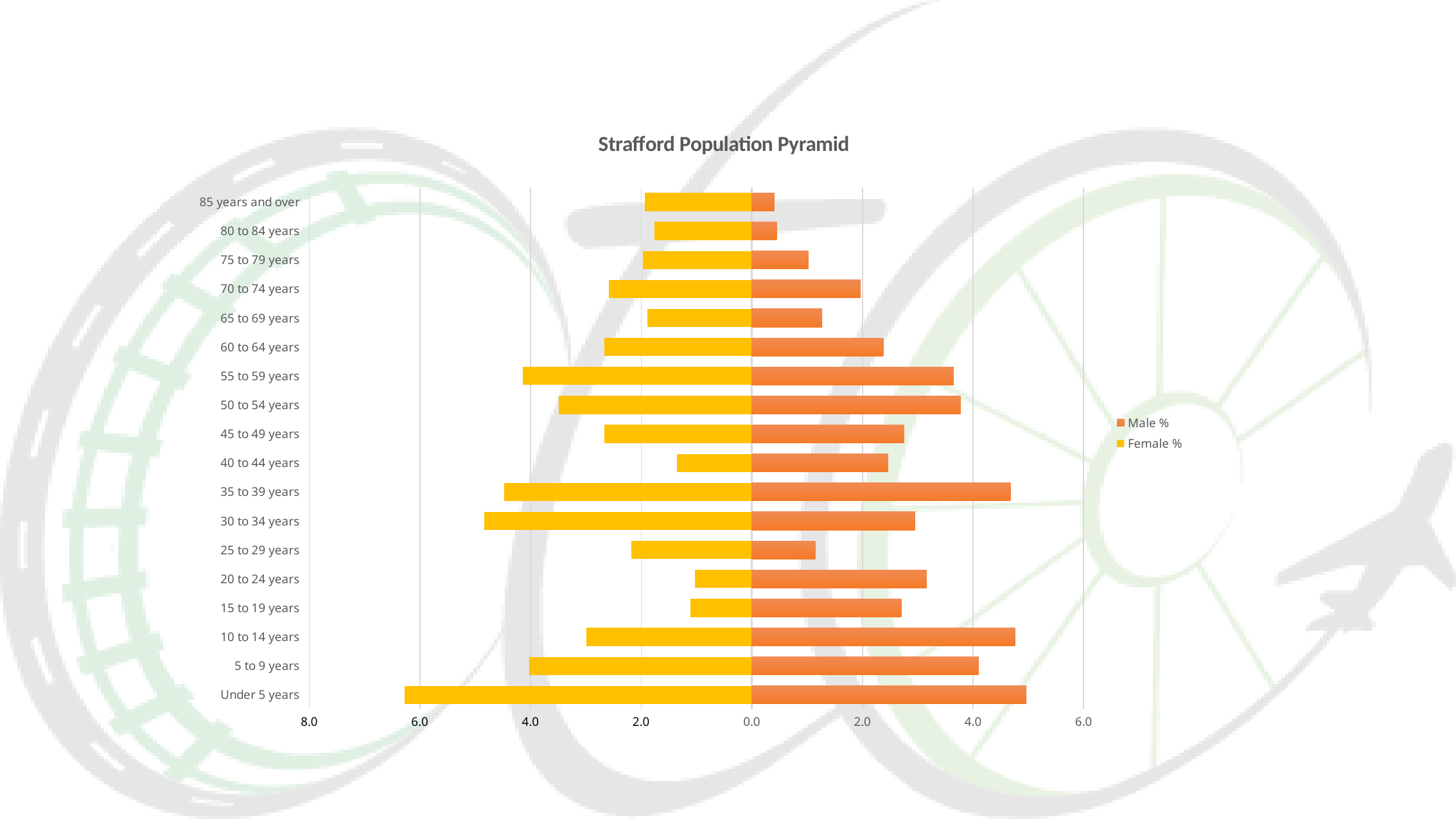
Is the Male % value for 85 years and over greater or less than 2.0? less Is the Female % value for 40 to 44 years greater or less than 2.0? less How many series does the legend list? 2 What kind of chart is shown on the slide? bar chart Which series is shown in yellow? Female % Which age group has the highest Female % value? Under 5 years Is the Female % value for Under 5 years greater or less than 4.0? greater How many age-group categories are plotted on the chart? 18 For 20 to 24 years, which is larger: Male % or Female %? Male % What is the title of the chart? Strafford Population Pyramid For 30 to 34 years, which is larger: Male % or Female %? Female %